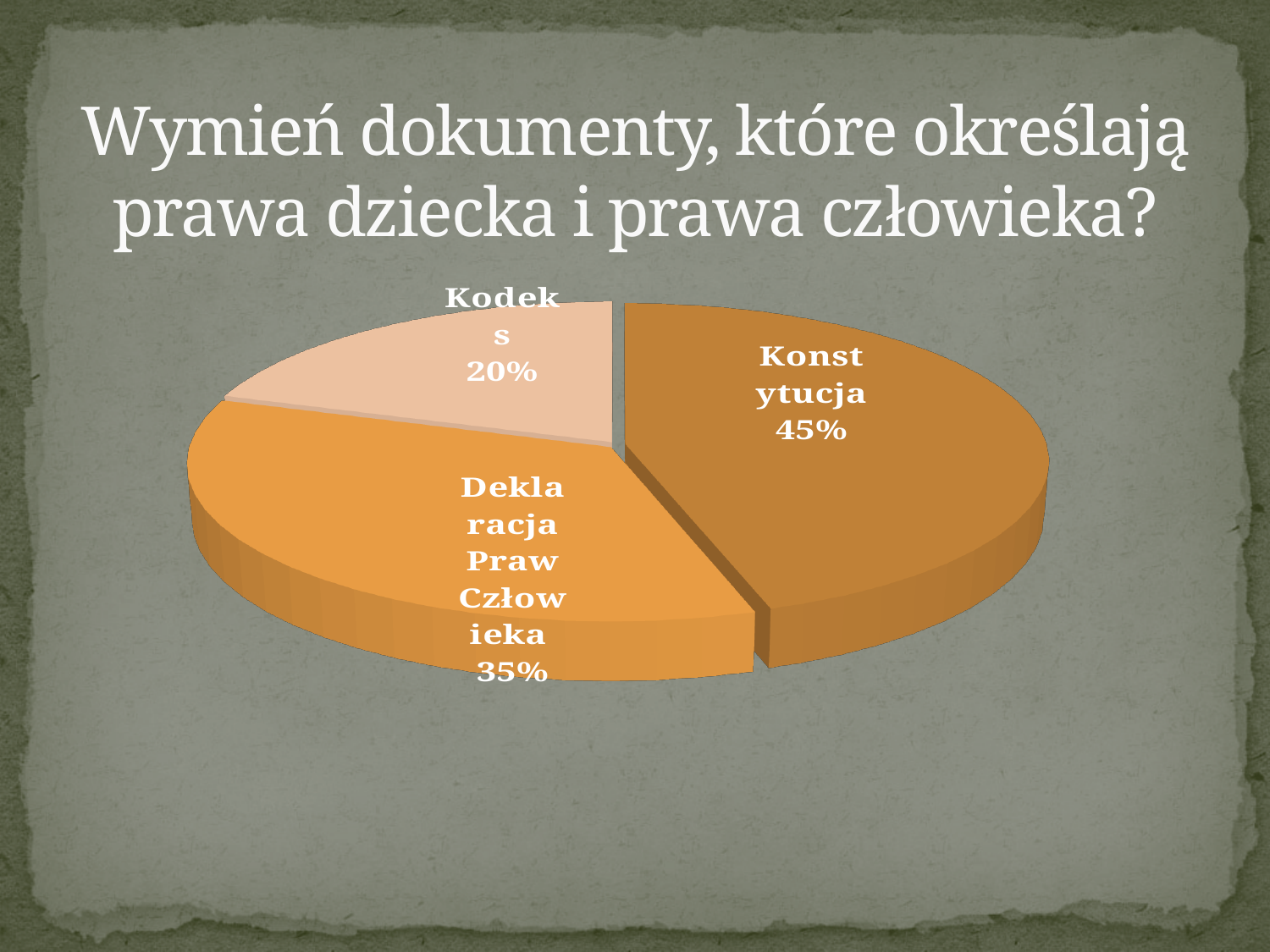
What kind of chart is shown on the slide? pie chart Which slice of the pie is separated (exploded) from the rest? Konstytucja What share of the pie does Deklaracja Praw Człowieka have? 35% Which slice of the pie is the largest? Konstytucja Which is larger, the share for Deklaracja Praw Człowieka or the share for Kodeks? Deklaracja Praw Człowieka What share of the pie does Kodeks have? 20% What is the difference in percentage points between Konstytucja and Deklaracja Praw Człowieka? 10 What share of the pie does Konstytucja have? 45% What is the title of the slide containing the pie chart? Wymień dokumenty, które określają prawa dziecka i prawa człowieka? How many slices does the pie chart have? 3 What is the difference in percentage points between Konstytucja and Kodeks? 25 Which slice of the pie is the smallest? Kodeks